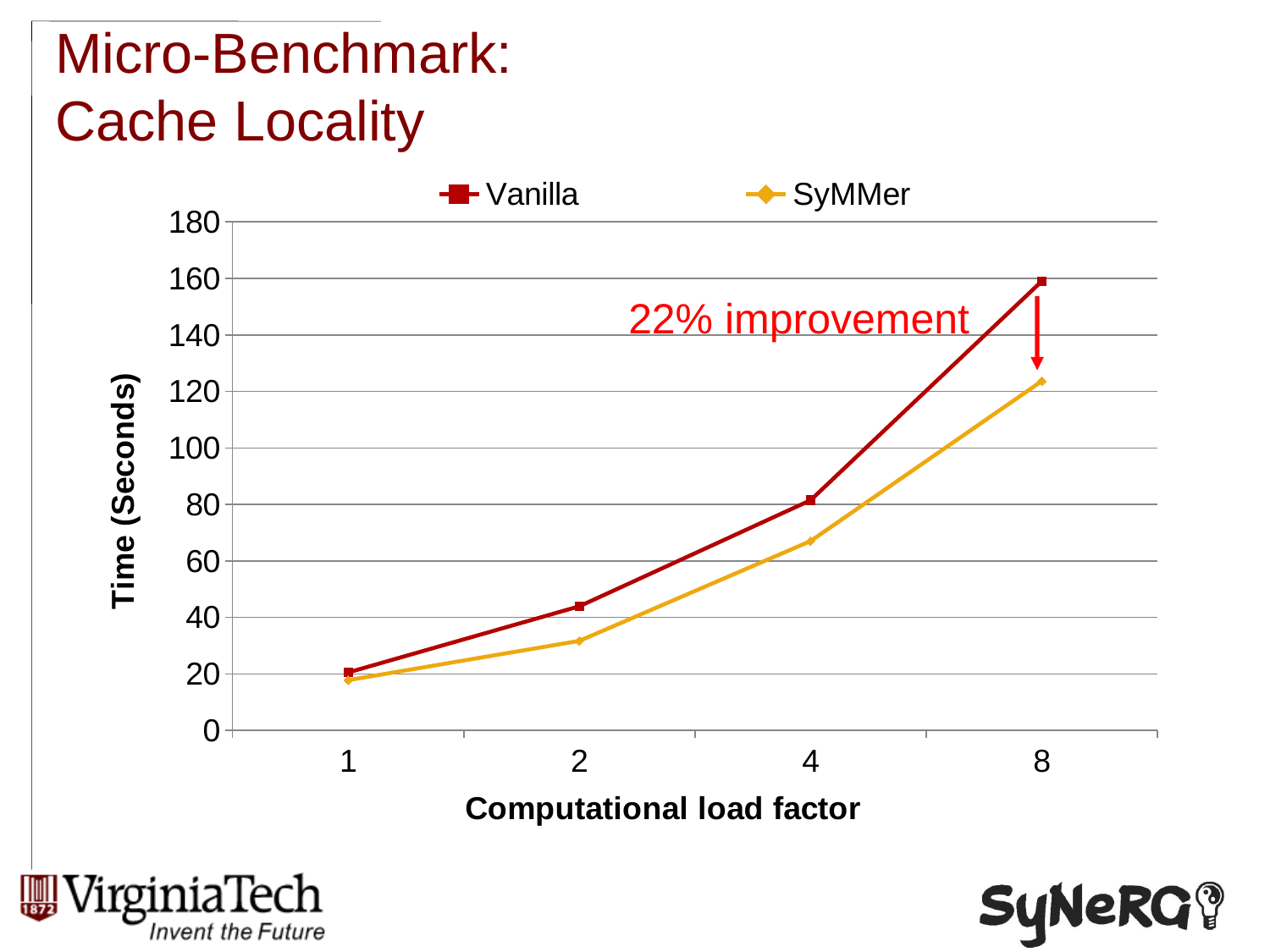
At which computational load factor is the Vanilla time highest? 8 What kind of chart is shown on the slide? line chart Is the Vanilla value at computational load factor 8 greater or less than 140? greater Is the Vanilla value at computational load factor 4 greater or less than 60? greater How many computational load factor values are plotted along the x axis? 4 Is the SyMMer value at computational load factor 8 greater or less than 140? less At a computational load factor of 8, which series has the larger time: Vanilla or SyMMer? Vanilla Do the Vanilla values rise or fall as the computational load factor increases? rise How many series does the legend list? 2 What improvement percentage is annotated on the chart? 22% improvement What is the label of the y axis? Time (Seconds) At which computational load factor is the SyMMer time lowest? 1